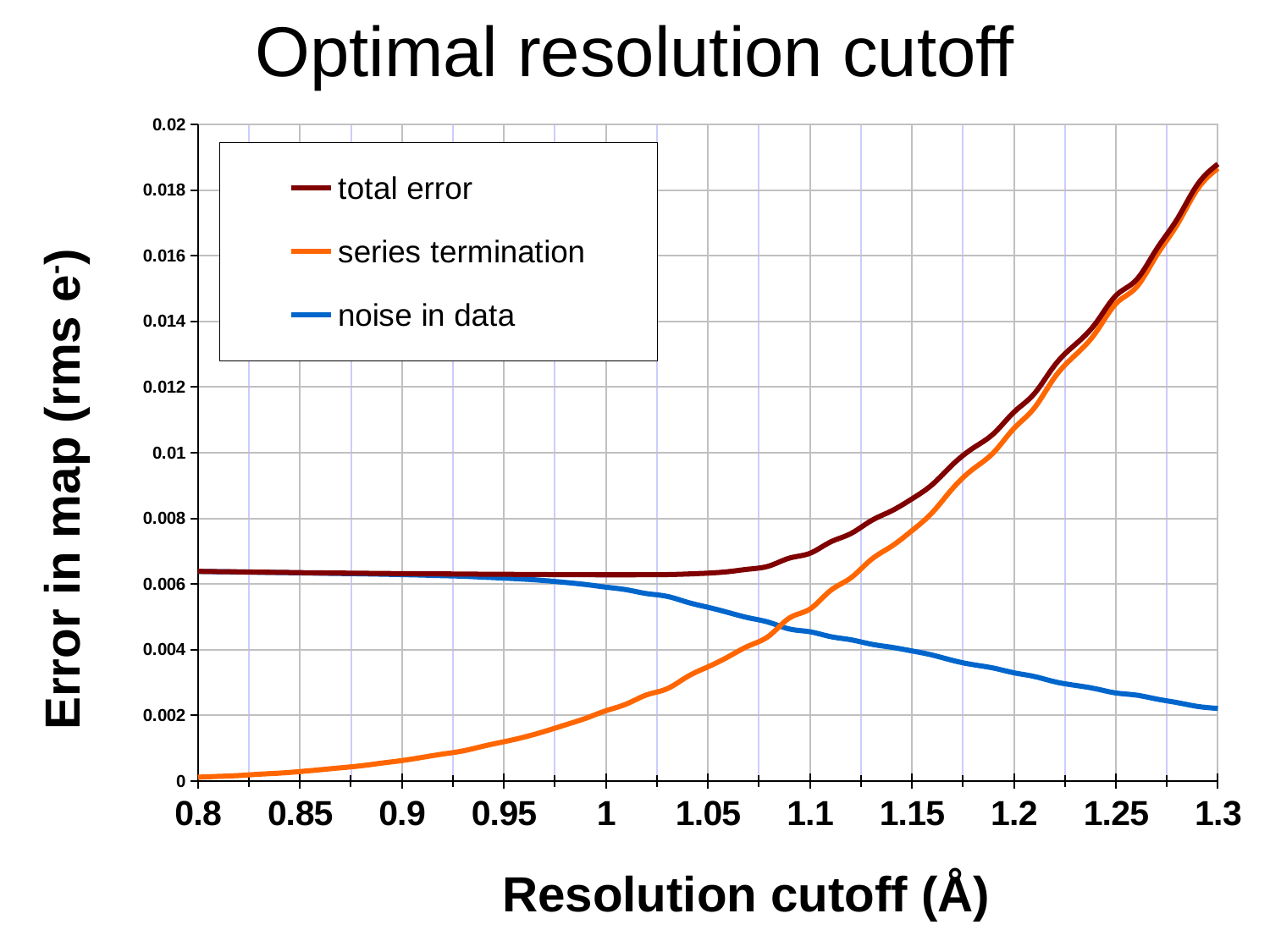
Does the 'noise in data' line rise or fall as the resolution cutoff increases from 0.8 to 1.3? fall What kind of chart is shown on the slide? line chart Is the value of 'noise in data' at a resolution cutoff of 1.3 greater or less than 0.004? less Which series has the lowest value at a resolution cutoff of 1.3? noise in data How many series does the legend list? 3 Is the value of 'series termination' at a resolution cutoff of 0.8 greater or less than 0.002? less Is the value of 'total error' at a resolution cutoff of 0.8 greater or less than 0.008? less What is the title of the chart? Optimal resolution cutoff Does the 'series termination' line rise or fall as the resolution cutoff increases from 0.8 to 1.3? rise At a resolution cutoff of 1.3, which is higher: 'series termination' or 'noise in data'? series termination At a resolution cutoff of 0.8, which is higher: 'noise in data' or 'series termination'? noise in data